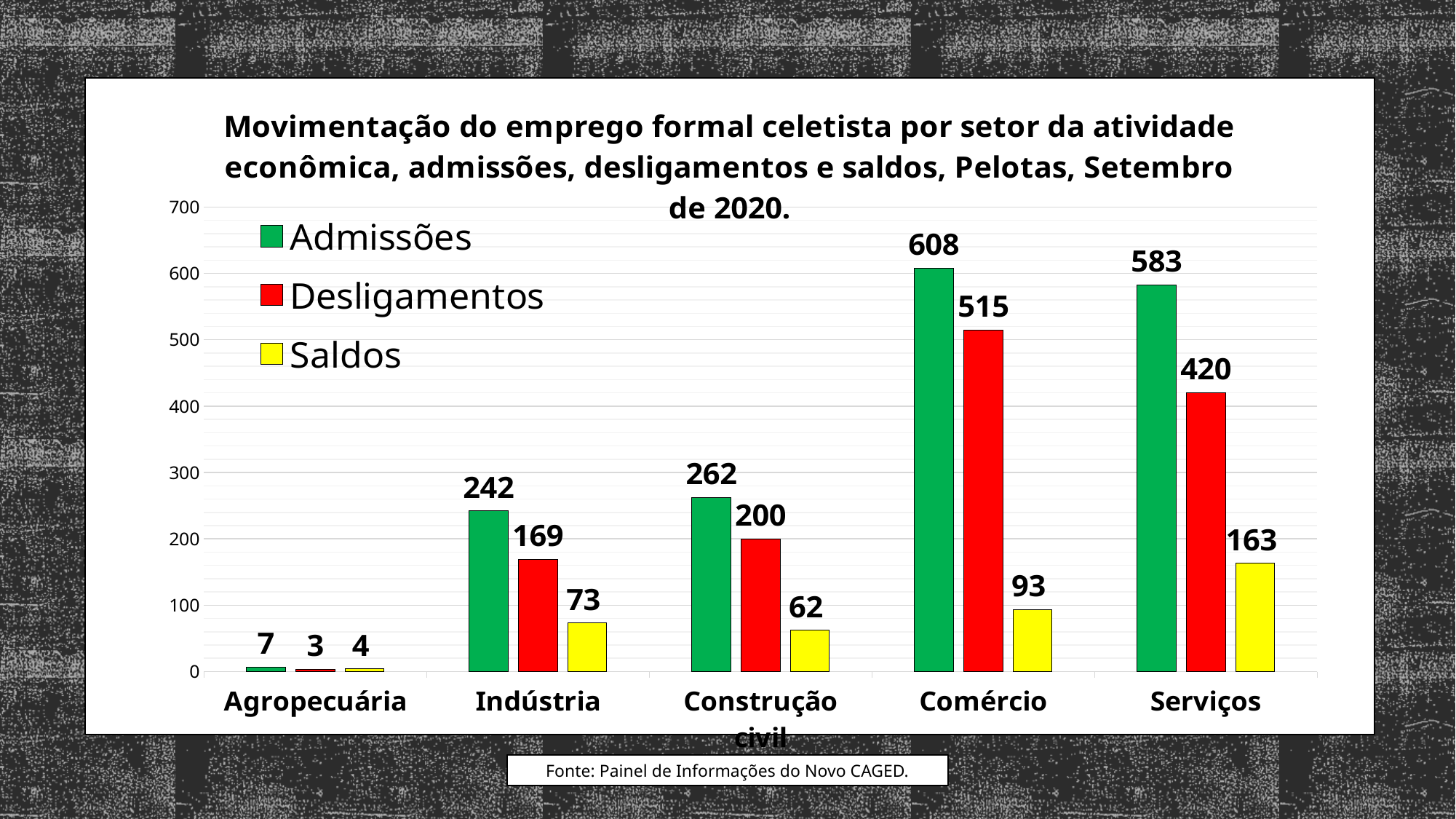
What is the value of Desligamentos for Serviços? 420 Which sector has the lowest value for Saldos? Agropecuária How many sectors are shown on the x axis? 5 What is the value of Desligamentos for Agropecuária? 3 Which is larger: Saldos for Serviços or Saldos for Comércio? Saldos for Serviços Which sector has the highest value for Admissões? Comércio What is the value of Admissões for Comércio? 608 What colour represents the Saldos series? Yellow How many series does the legend list? 3 What is the difference between Admissões and Desligamentos for Construção civil? 62 What kind of chart is shown on the slide? Bar chart What is the value of Saldos for Indústria? 73